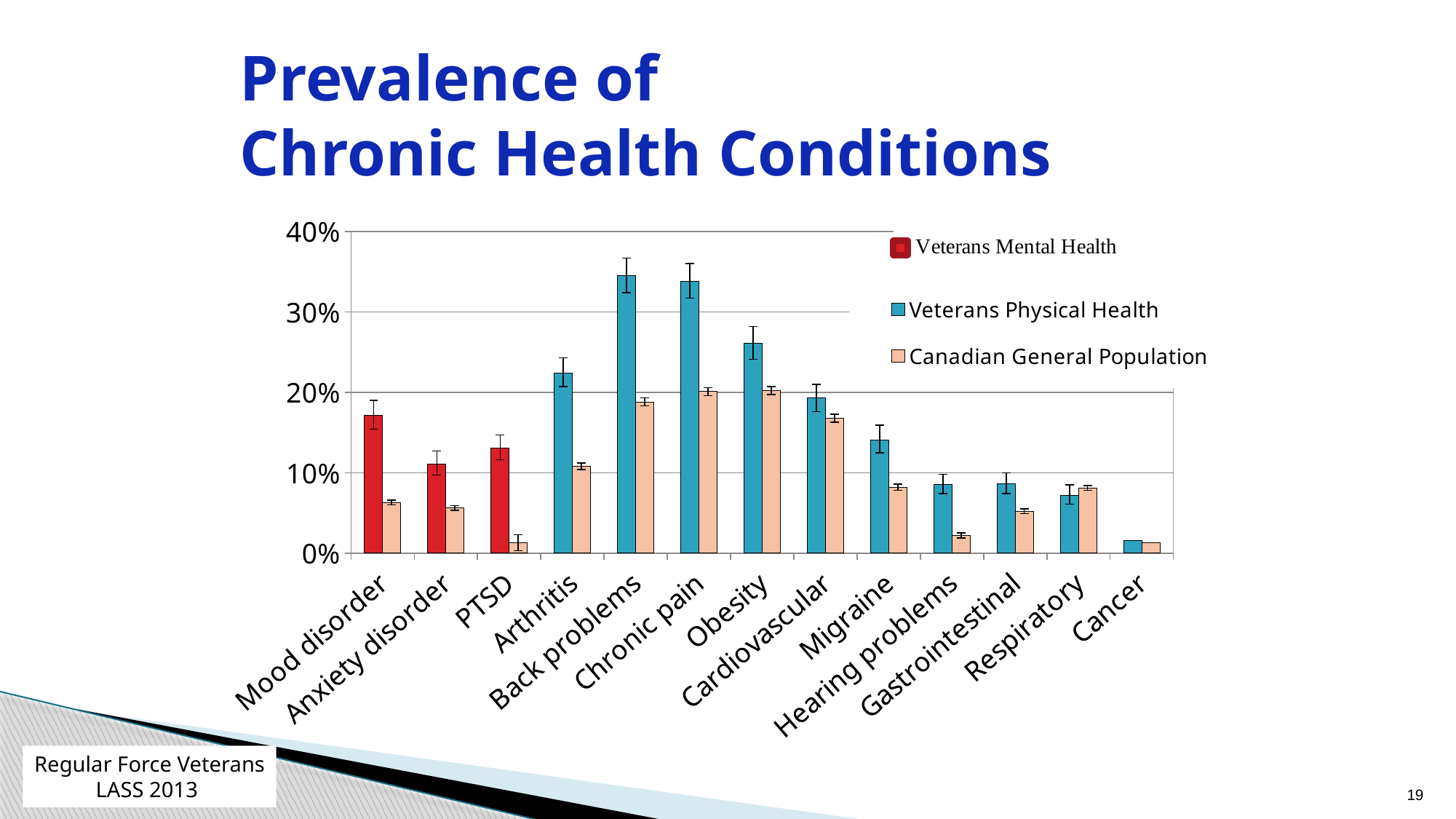
Which condition has the lowest prevalence among veterans? Cancer Is the Veterans Physical Health value for Back problems greater or less than 30%? greater Is the Veterans Physical Health value for Obesity greater or less than 20%? greater What kind of chart is shown on the slide? bar chart Which series is shown in red? Veterans Mental Health How many health conditions are shown on the x axis? 13 Is the Canadian General Population value for PTSD greater or less than 10%? less What is the highest value shown on the y axis? 40% How many series does the legend list? 3 For Arthritis, which is larger: the Veterans Physical Health value or the Canadian General Population value? Veterans Physical Health